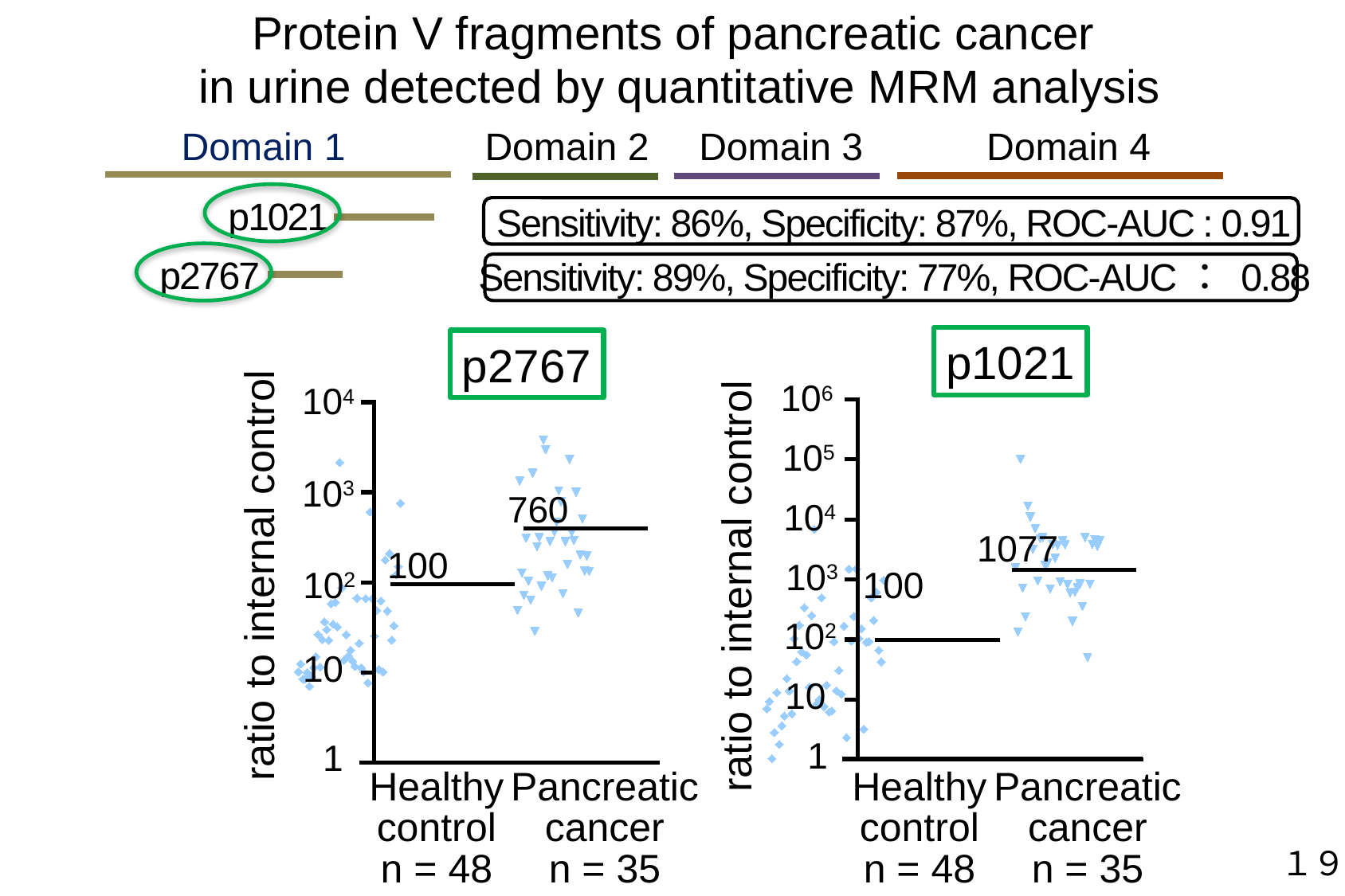
In the p1021 chart, what is the difference between the labelled median values of the Pancreatic cancer and Healthy control groups? 977 In the p2767 chart, what is the labelled median value for the Pancreatic cancer group? 760 What is the sample size (n) of the Healthy control group in the p1021 chart? 48 In the p1021 chart, what is the labelled median value for the Pancreatic cancer group? 1077 In the p2767 chart, what is the labelled median value for the Healthy control group? 100 In the p2767 chart, which group has the higher labelled median value, Healthy control or Pancreatic cancer? Pancreatic cancer In the p1021 chart, what is the labelled median value for the Healthy control group? 100 In the p1021 chart, is the labelled median for the Pancreatic cancer group greater or less than 1000? greater Which chart shows the higher labelled median for the Pancreatic cancer group, p2767 or p1021? p1021 How many groups are plotted along the x axis of the p2767 chart? 2 What is the y-axis label of the p2767 chart? ratio to internal control In the p2767 chart, what is the difference between the labelled median values of the Pancreatic cancer and Healthy control groups? 660